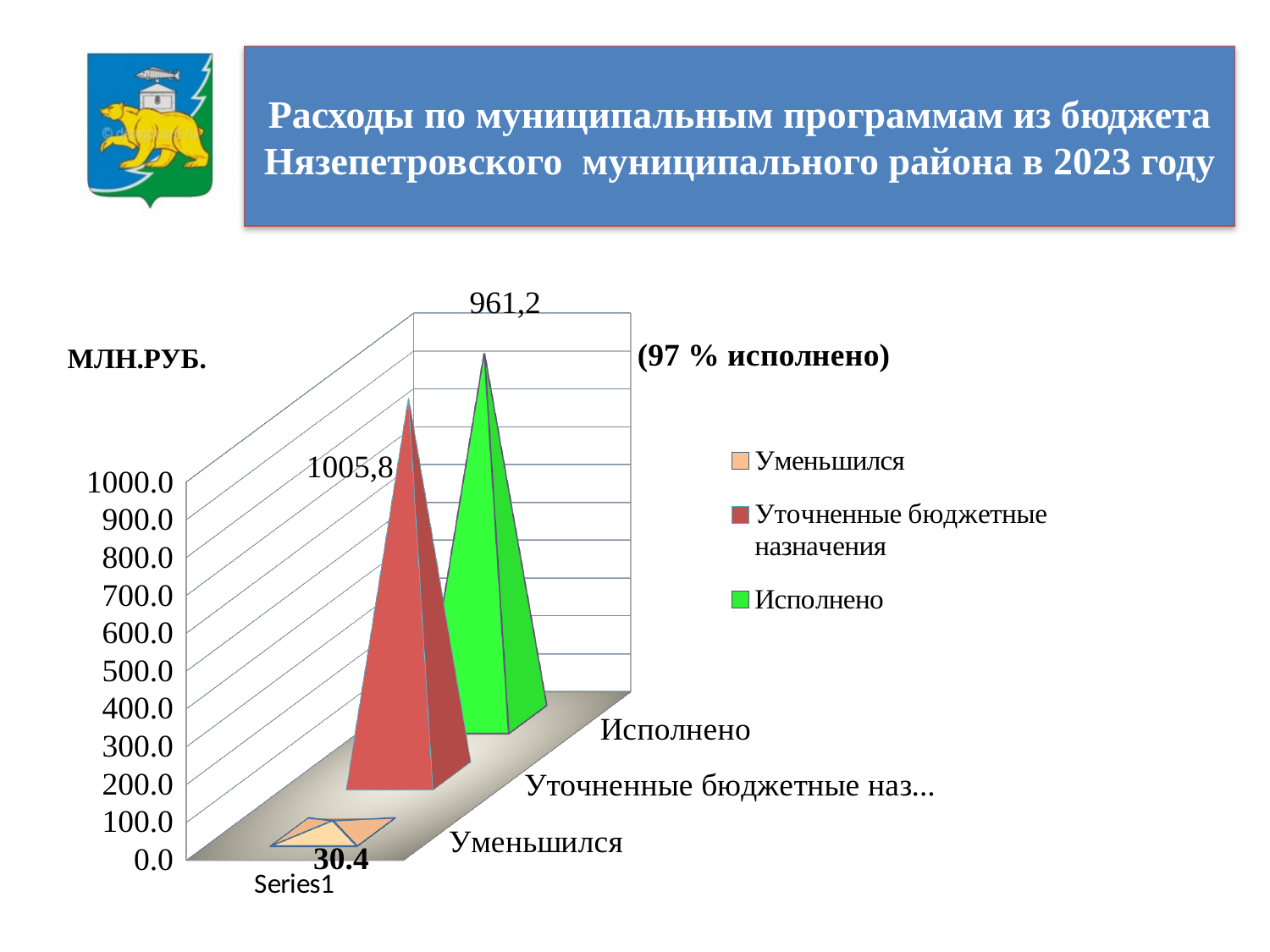
What is the difference between Уточненные бюджетные назначения and Исполнено? 44,6 What is the value for Уменьшился? 30.4 What kind of chart is shown on the slide? bar chart Which series has the lowest value? Уменьшился Is the value for Исполнено greater or less than 900? greater What unit of measurement is indicated for the chart values? МЛН.РУБ. How many series does the legend list? 3 Which is larger, Исполнено or Уменьшился? Исполнено What is the value for Уточненные бюджетные назначения? 1005,8 What is the value for Исполнено? 961,2 Which series has the highest value? Уточненные бюджетные назначения What percentage of the budget is stated as executed (исполнено) on the slide? 97 %